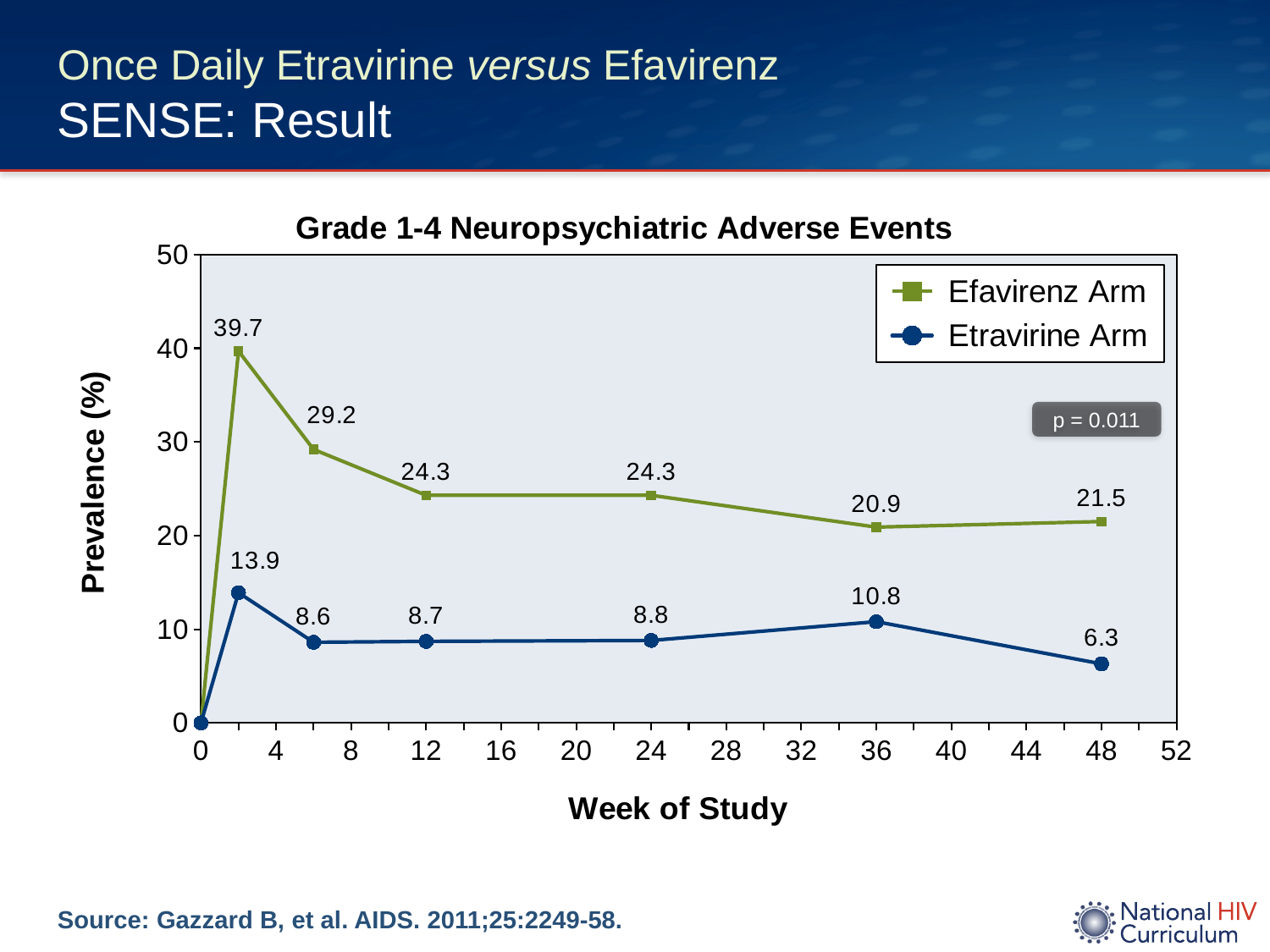
What type of chart is shown on the slide? line chart At week 48, which arm has the higher prevalence? Efavirenz Arm Does the Efavirenz Arm prevalence generally rise or fall from its peak to week 48? fall What is the lowest labeled value for the Etravirine Arm? 6.3 What is the highest labeled value for the Efavirenz Arm? 39.7 What is the prevalence for the Efavirenz Arm at week 12? 24.3 What p-value is shown on the chart? p = 0.011 What is the difference between the Efavirenz Arm and the Etravirine Arm at week 24? 15.5 What is the prevalence for the Efavirenz Arm at week 36? 20.9 What is the prevalence for the Etravirine Arm at week 36? 10.8 How many series does the legend list? 2 What is the prevalence for the Etravirine Arm at week 48? 6.3